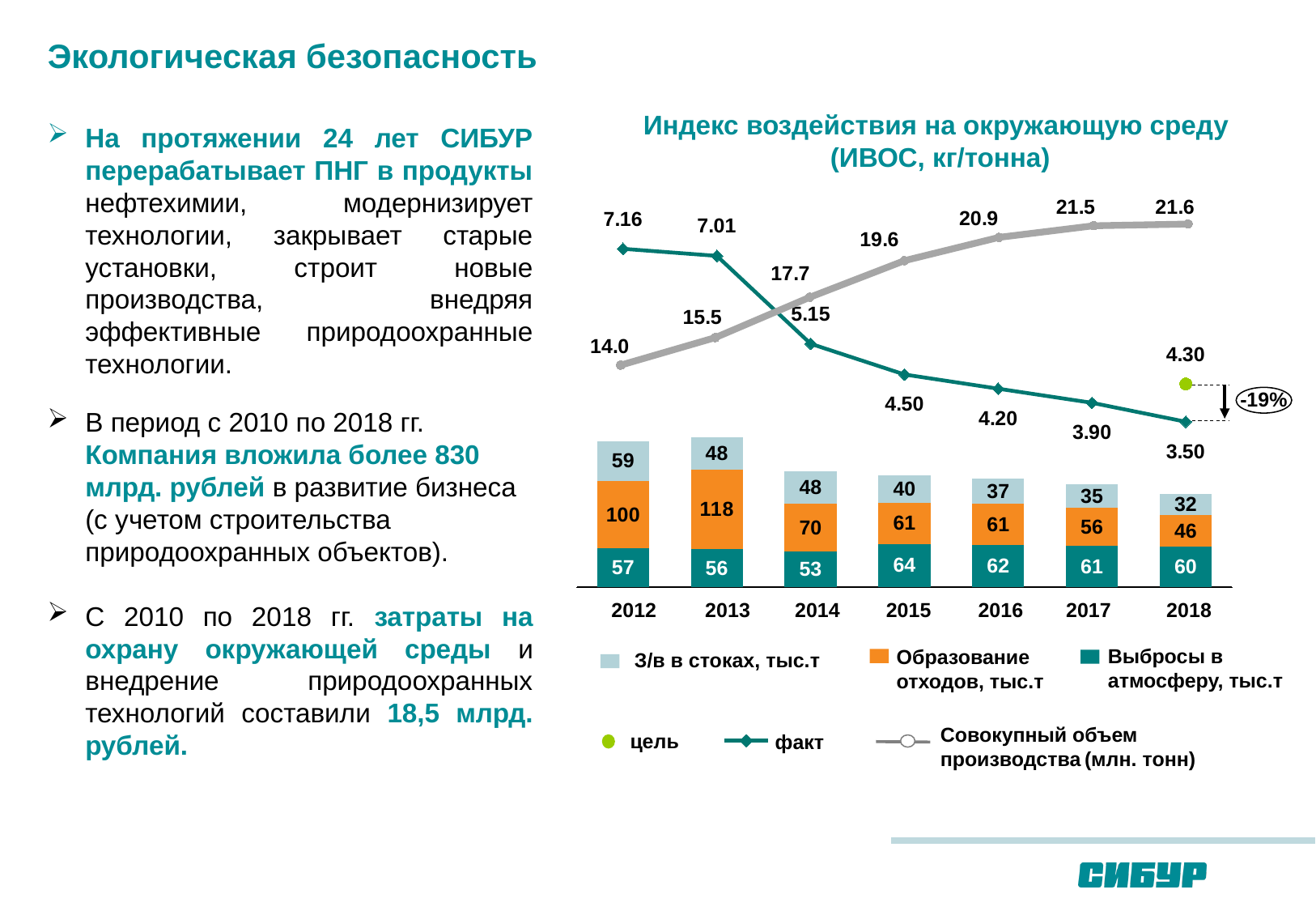
What is the 'цель' value shown for 2018? 4.30 In which year is 'Образование отходов, тыс.т' highest? 2013 Does the 'Совокупный объем производства (млн. тонн)' series rise or fall from 2012 to 2018? rise What is the total of the stacked bar for 2018? 138 How many series does the legend list? 6 Which is larger: 'Выбросы в атмосферу, тыс.т' in 2015 or in 2014? 2015 How many years are shown on the x axis? 7 What is the 'Образование отходов, тыс.т' value for 2013? 118 What is the difference between the 'факт' values in 2012 and 2018? 3.66 In which year is the 'факт' series at its lowest? 2018 What is the 'Совокупный объем производства (млн. тонн)' value for 2016? 20.9 What is the value of the 'факт' series in 2014? 5.15